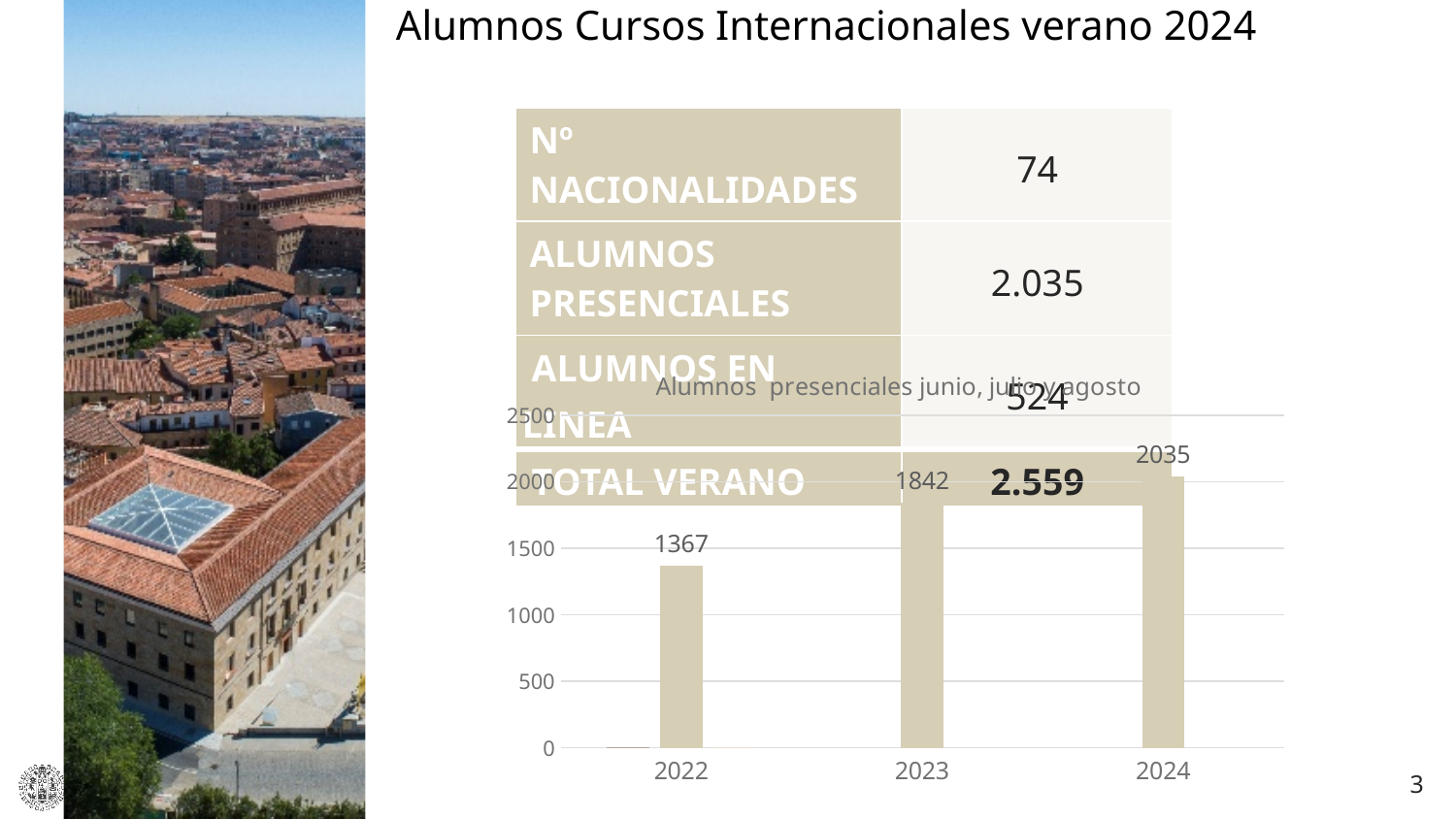
What is the value for 2024 in the chart? 2035 Which year has the highest value in the chart? 2024 What is the difference between the values for 2024 and 2022? 668 What is the value for 2023 in the chart? 1842 What kind of chart is shown on the slide? bar chart How many years are shown on the x axis of the chart? 3 What is the value for 2022 in the chart? 1367 Which is larger, the value for 2023 or the value for 2024? 2024 Do the values rise or fall from 2022 to 2024? rise Is the value for 2022 greater or less than 1500? less Which year has the lowest value in the chart? 2022 What is the difference between the values for 2023 and 2022? 475